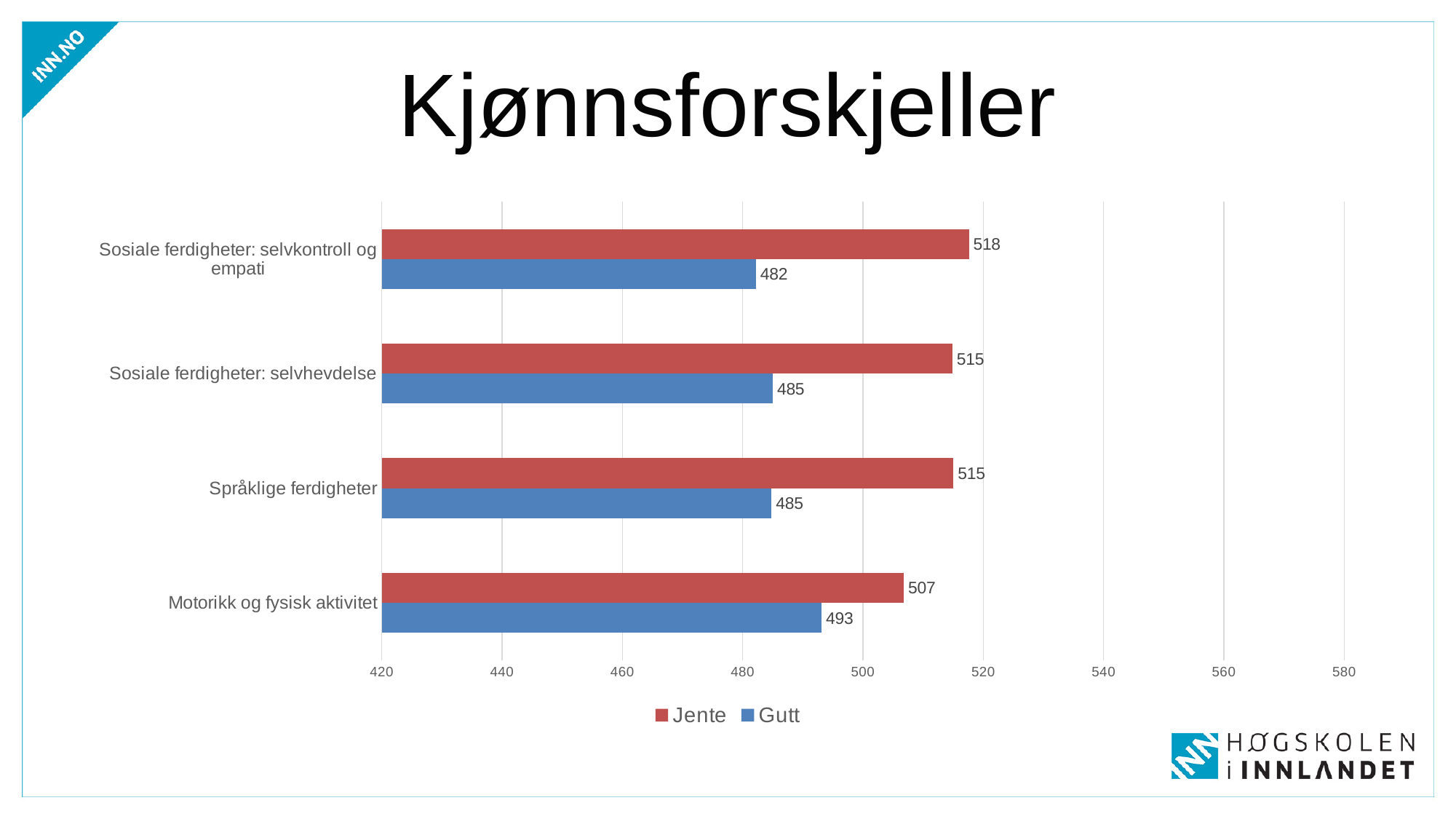
Which category has the lowest Gutt value? Sosiale ferdigheter: selvkontroll og empati What is the Jente value for Motorikk og fysisk aktivitet? 507 How many categories are shown on the chart? 4 What is the difference between the Jente and Gutt values for Motorikk og fysisk aktivitet? 14 What is the difference between the Jente and Gutt values for Sosiale ferdigheter: selvkontroll og empati? 36 What is the Gutt value for Sosiale ferdigheter: selvkontroll og empati? 482 Which is larger: the Jente value for Motorikk og fysisk aktivitet or the Jente value for Språklige ferdigheter? Språklige ferdigheter What is the Gutt value for Språklige ferdigheter? 485 How many series does the legend list? 2 Which category has the highest Gutt value? Motorikk og fysisk aktivitet What kind of chart is shown on the slide? Bar chart Which category has the highest Jente value? Sosiale ferdigheter: selvkontroll og empati